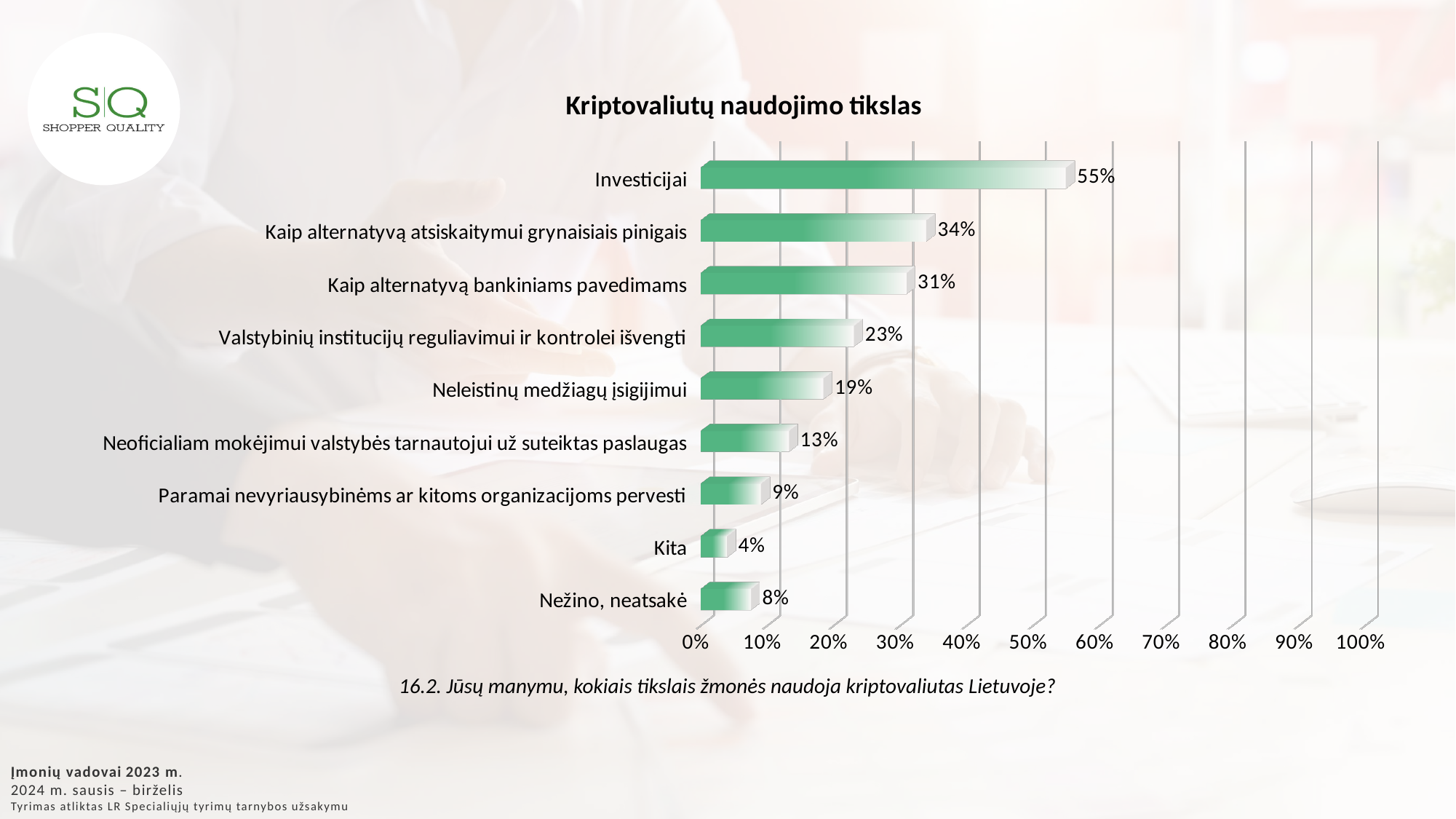
What is the title of the chart? Kriptovaliutų naudojimo tikslas How many categories are shown in the chart? 9 What is the value for Kaip alternatyvą bankiniams pavedimams? 31% What is the value for Nežino, neatsakė? 8% What is the value for Investicijai? 55% What kind of chart is shown on the slide? bar chart What is the difference between the values for Investicijai and Kaip alternatyvą atsiskaitymui grynaisiais pinigais? 21% Which category has the highest value? Investicijai Which category has the lowest value? Kita Is the value for Valstybinių institucijų reguliavimui ir kontrolei išvengti greater or less than 30%? less Which is larger: the value for Kita or the value for Nežino, neatsakė? Nežino, neatsakė What is the value for Neleistinų medžiagų įsigijimui? 19%